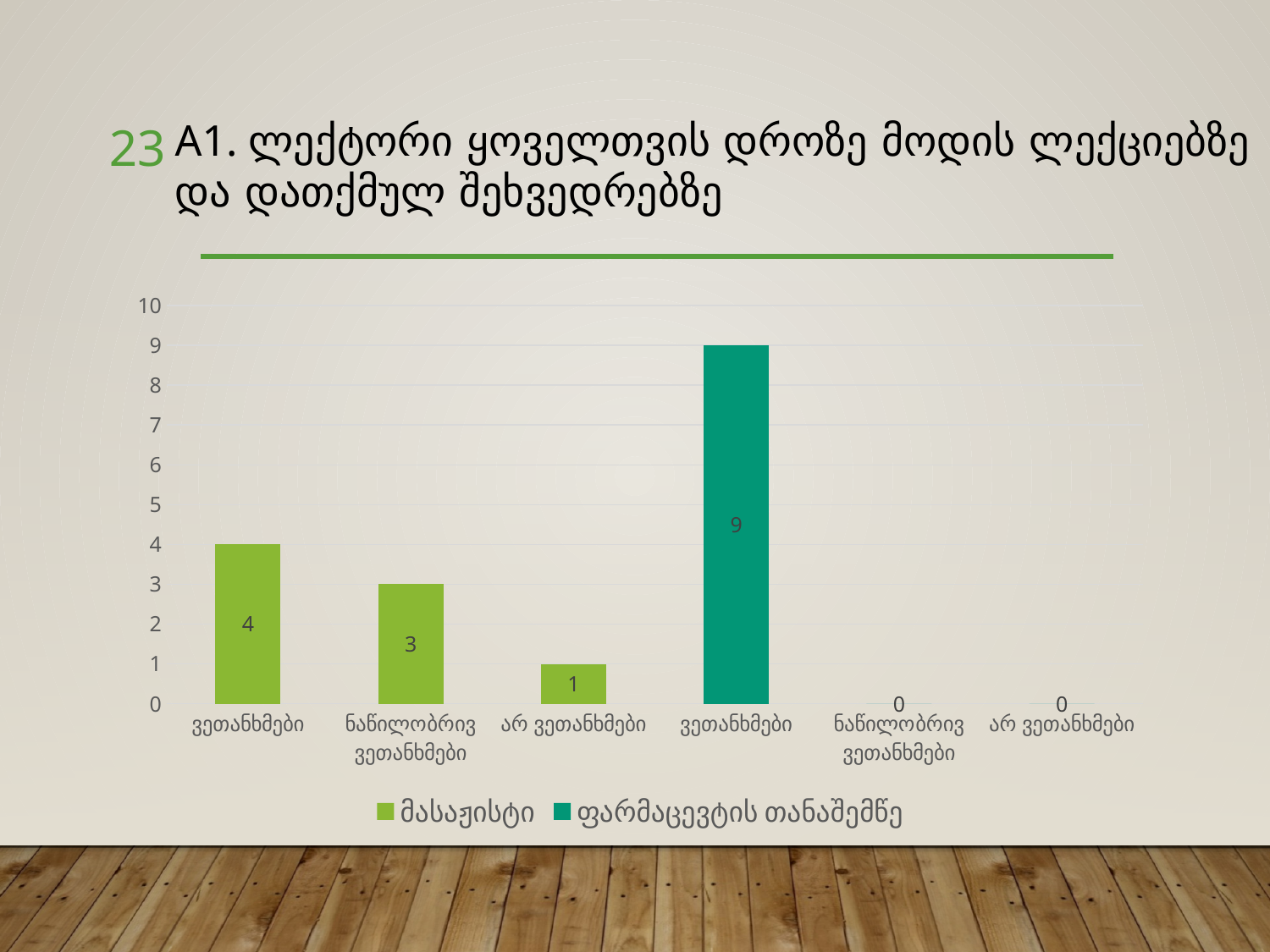
What kind of chart is shown on the slide? bar chart Which bar has the highest value? ვეთანხმები (ფარმაცევტის თანაშემწე), 9 What is the value of the teal ვეთანხმები bar (ფარმაცევტის თანაშემწე)? 9 How many bars (categories) are shown along the x axis? 6 What is the difference between the teal ვეთანხმები bar (9) and the green ვეთანხმები bar (4)? 5 What is the value of the არ ვეთანხმები bar in the green მასაჟისტი group? 1 What is the value of the first ვეთანხმები bar (the green მასაჟისტი group)? 4 What is the value of the ნაწილობრივ ვეთანხმები bar in the green მასაჟისტი group? 3 How many series does the legend list? 2 What is the value of the last არ ვეთანხმები category on the right? 0 What is the second entry in the legend? ფარმაცევტის თანაშემწე Which is larger: the green ნაწილობრივ ვეთანხმები bar or the green არ ვეთანხმები bar? ნაწილობრივ ვეთანხმები